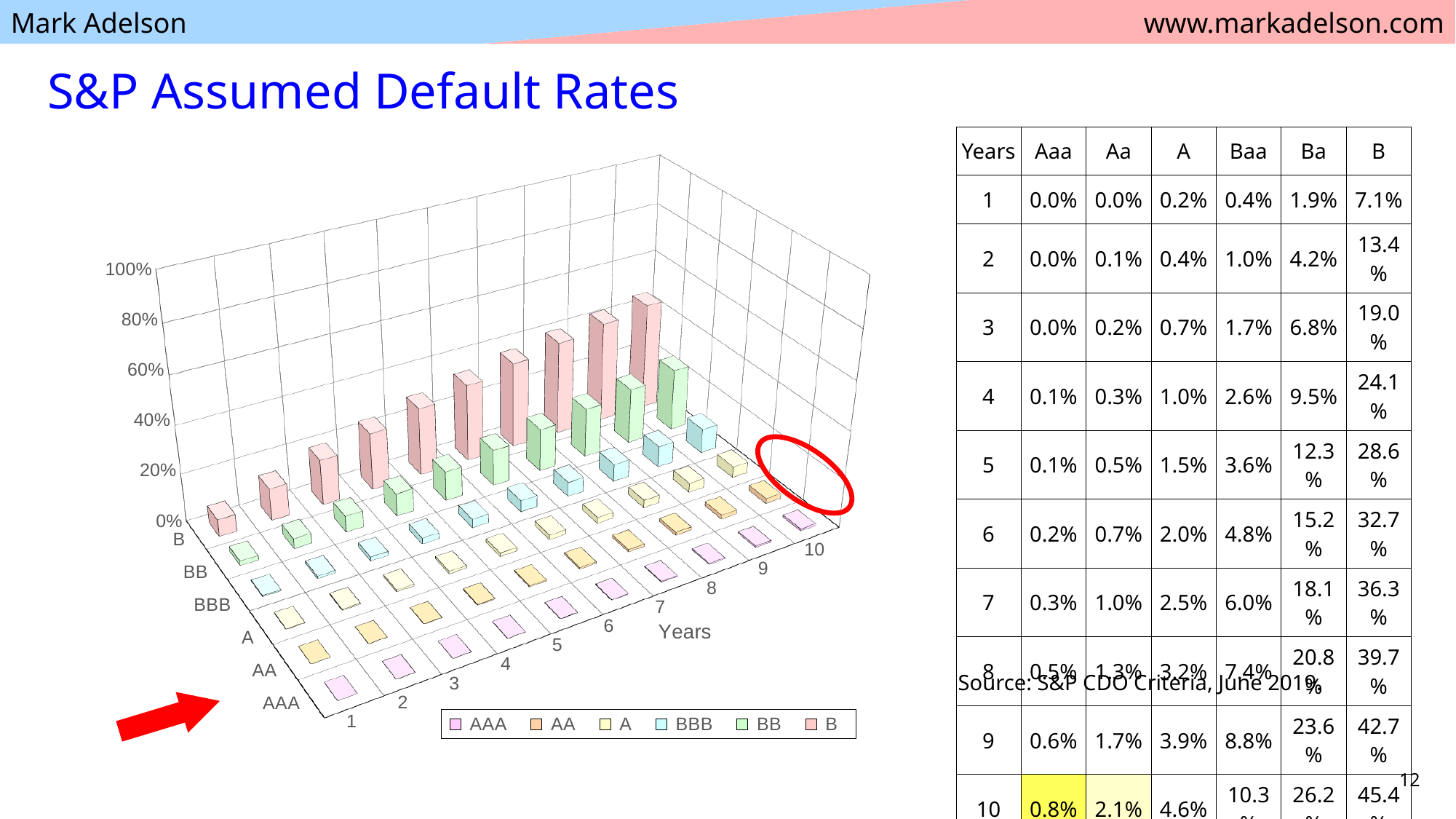
What is the label of the horizontal axis of the chart? Years At year 10, which is larger: the value for B or the value for AAA? B Is the value for the AAA series at year 10 greater or less than 20%? less What is the title of the chart on the slide? S&P Assumed Default Rates Do the values for the B series rise or fall as the years increase from 1 to 10? rise Is the value for the B series at year 10 greater or less than 20%? greater How many series does the chart's legend list? 6 Is the value for the B series at year 1 greater or less than 20%? less At year 5, which is larger: the value for B or the value for BB? B What kind of chart is shown on the slide? bar chart Which rating series has the tallest bar at year 10? B How many years are shown along the x axis of the chart? 10